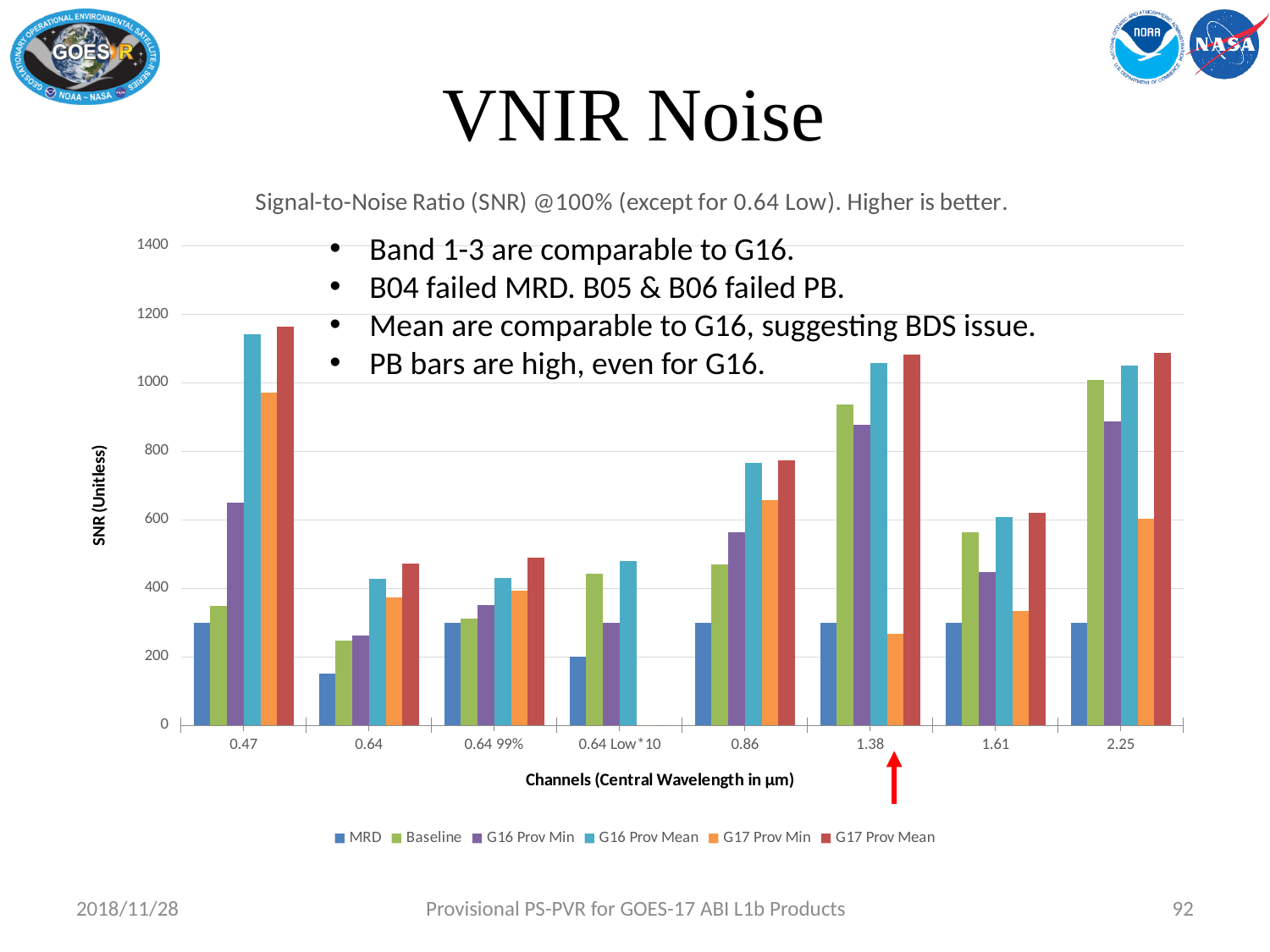
Is the G17 Prov Mean value for the 0.47 channel greater or less than 1000? greater For the 1.38 channel, which is larger: G16 Prov Min or G17 Prov Min? G16 Prov Min How many channel categories are shown on the x axis? 8 Which channel has the highest G17 Prov Mean value? 0.47 Is the G17 Prov Min value for the 1.38 channel greater or less than 400? less Is the Baseline value for the 1.38 channel greater or less than 800? greater Which channel has the lowest MRD value? 0.64 What is the title of the y axis? SNR (Unitless) How many series does the legend list? 6 What kind of chart is shown on the slide? bar chart